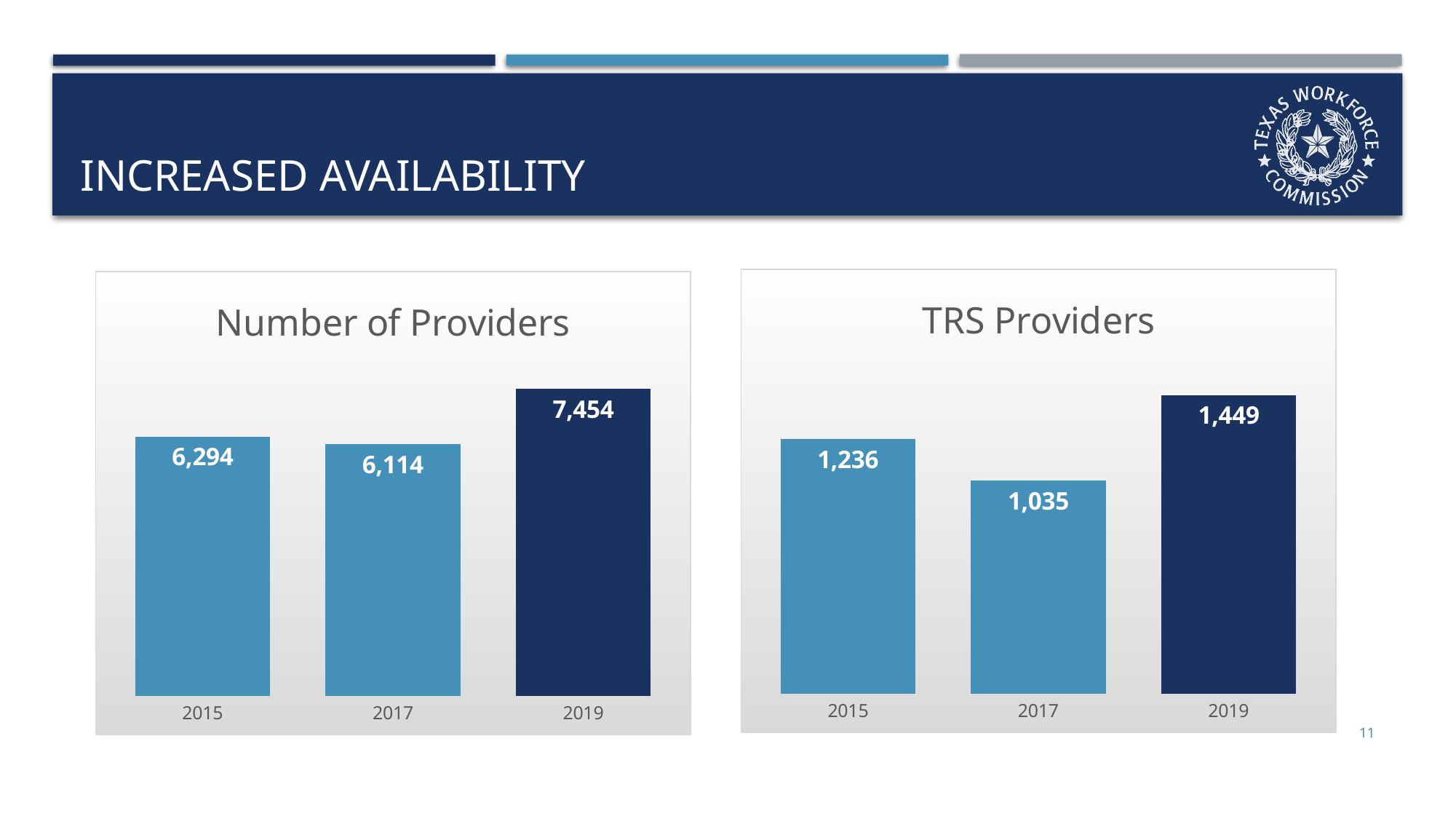
In the 'TRS Providers' chart, what is the difference between the 2015 and 2017 values? 201 In the 'TRS Providers' chart, which year has the lowest value? 2017 In the 'Number of Providers' chart, which year has the highest value? 2019 In the 'Number of Providers' chart, what is the difference between the 2019 and 2017 values? 1,340 In the 'Number of Providers' chart, what is the value for 2017? 6,114 In the 'Number of Providers' chart, what is the value for 2015? 6,294 In the 'TRS Providers' chart, which is larger, the value for 2015 or the value for 2019? 2019 What is the title of the chart on the left side of the slide? Number of Providers In the 'TRS Providers' chart, what is the value for 2019? 1,449 In the 'TRS Providers' chart, what is the value for 2017? 1,035 What kind of chart is the 'TRS Providers' chart? Bar chart How many years are shown in the 'Number of Providers' chart? 3